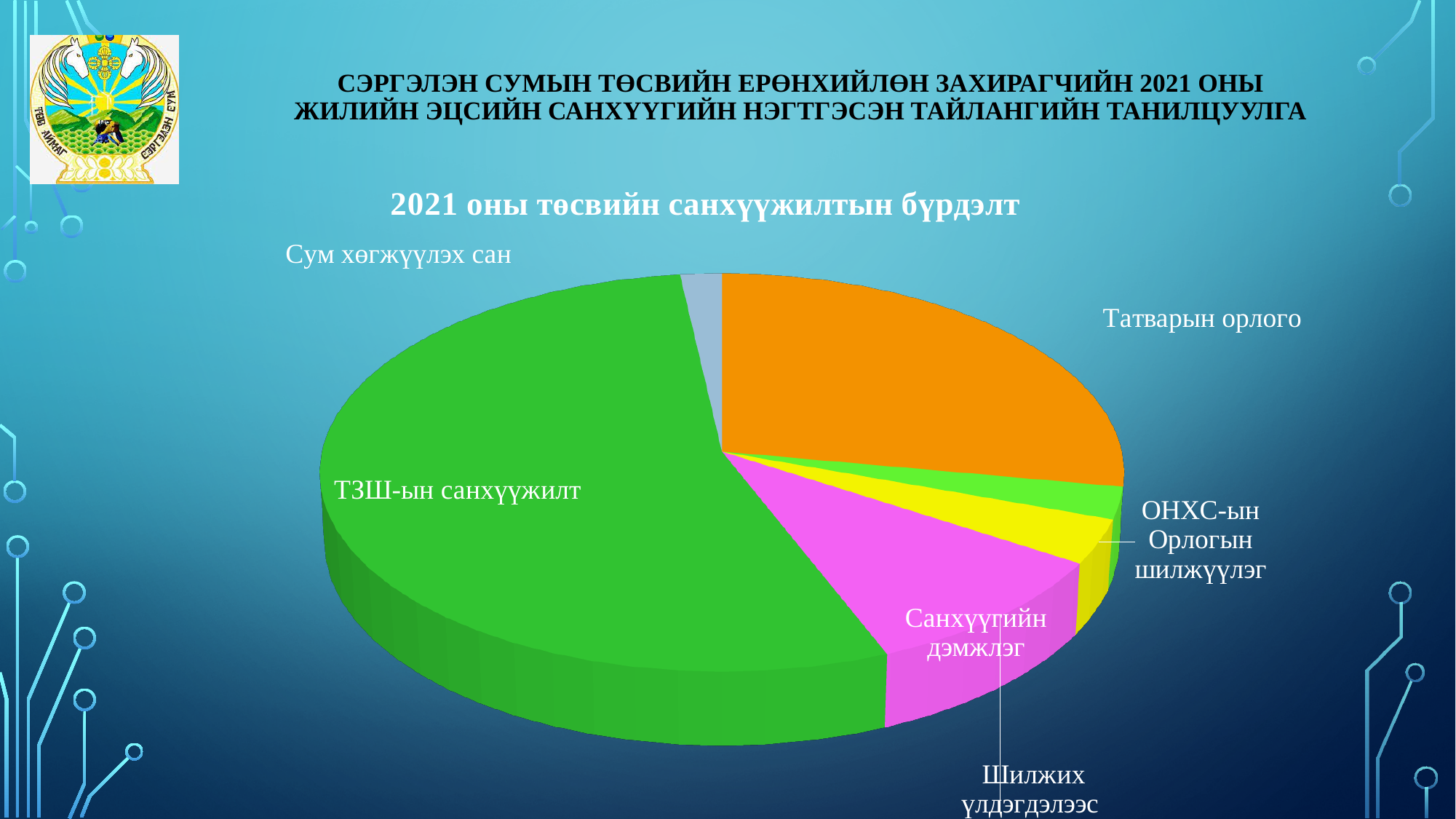
What kind of chart is shown on the slide? Pie chart Which category has the largest slice of the pie chart? ТЗШ-ын санхүүжилт What is the title of the pie chart? 2021 оны төсвийн санхүүжилтын бүрдэлт How many slices does the pie chart have? 6 Which slice is larger, Татварын орлого or Санхүүгийн дэмжлэг? Татварын орлого Which slice is larger, Татварын орлого or Сум хөгжүүлэх сан? Татварын орлого Which slice is larger, Санхүүгийн дэмжлэг or Шилжих үлдэгдэлээс? Шилжих үлдэгдэлээс What colour is the ТЗШ-ын санхүүжилт slice in the pie chart? Green